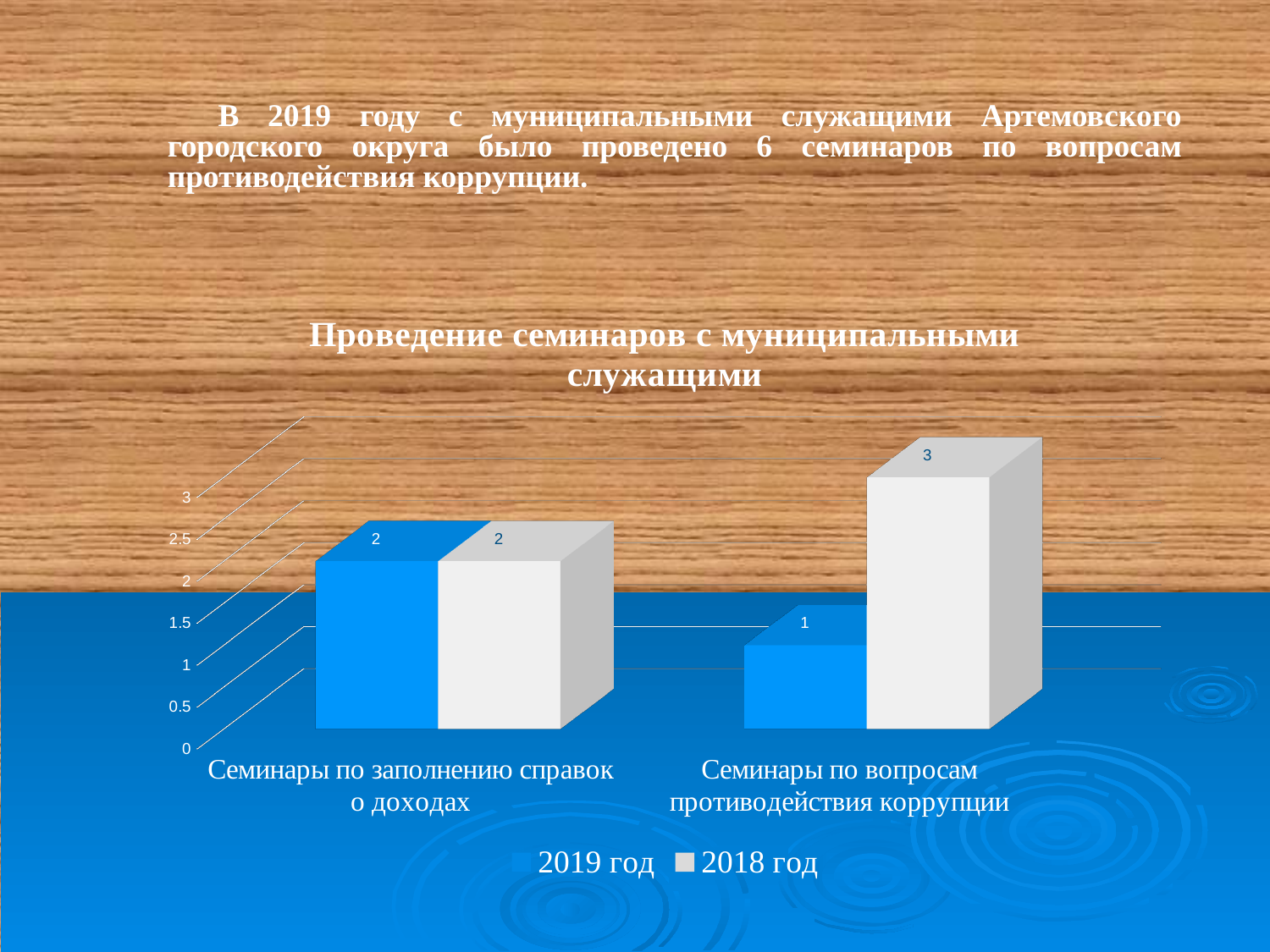
Which category has the lowest value for the 2019 год series? Семинары по вопросам противодействия коррупции What is the title of the chart? Проведение семинаров с муниципальными служащими For 'Семинары по вопросам противодействия коррупции', which series has the larger value, 2019 год or 2018 год? 2018 год How many categories are shown on the x axis? 2 What is the value for 2018 год for 'Семинары по вопросам противодействия коррупции'? 3 What is the difference between the 2018 год and 2019 год values for 'Семинары по вопросам противодействия коррупции'? 2 What is the value for 2019 год for 'Семинары по заполнению справок о доходах'? 2 How many series does the legend list? 2 What kind of chart is shown on the slide? bar chart Which category has the highest value for the 2018 год series? Семинары по вопросам противодействия коррупции What is the value for 2018 год for 'Семинары по заполнению справок о доходах'? 2 What is the value for 2019 год for 'Семинары по вопросам противодействия коррупции'? 1